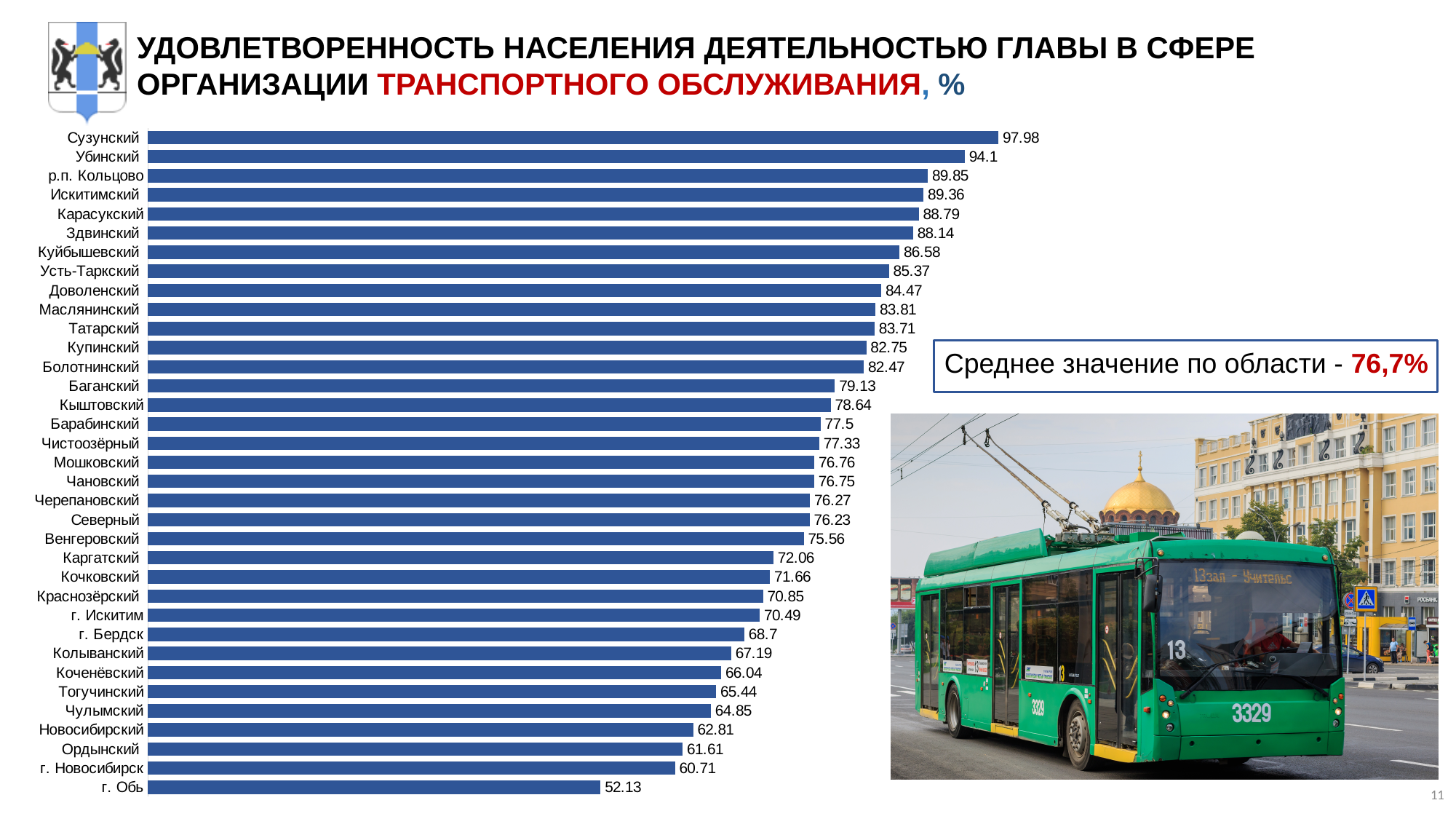
What is the value for г. Обь? 52.13 What is the difference between the values for Сузунский and г. Обь? 45.85 Which category has the highest value? Сузунский How many categories are shown in the chart? 35 What is the average value for the region stated on the slide? 76,7% What is the value for г. Новосибирск? 60.71 What kind of chart is shown on the slide? Bar chart Which category has the lowest value? г. Обь What is the value for Болотнинский? 82.47 Which is larger, the value for Каргатский or the value for Чулымский? Каргатский What is the difference between the values for г. Бердск and Колыванский? 1.51 What is the value for Сузунский? 97.98